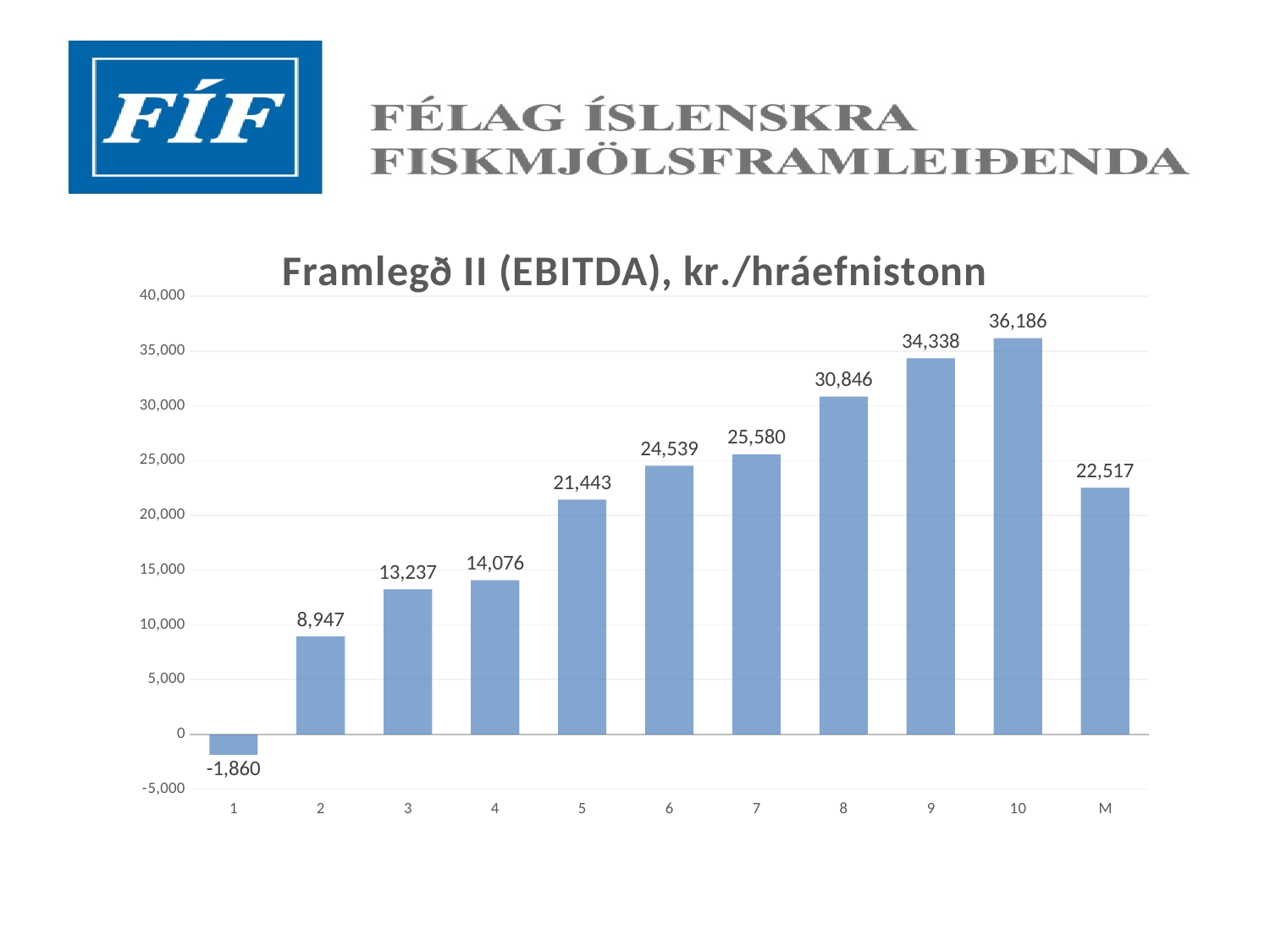
What is the title of the chart? Framlegð II (EBITDA), kr./hráefnistonn What kind of chart is this? bar chart Which category has the lowest value? 1 Is the value for category 7 greater or less than 25,000? greater Do the values rise or fall from category 1 to category 10? rise Which category has the highest value? 10 What is the difference between the values for category 10 and category 9? 1,848 What is the value for category 5? 21,443 Which is larger, the value for category 8 or the value for category M? 8 What is the value for category M? 22,517 How many categories are shown on the x axis? 11 What is the value for category 1? -1,860